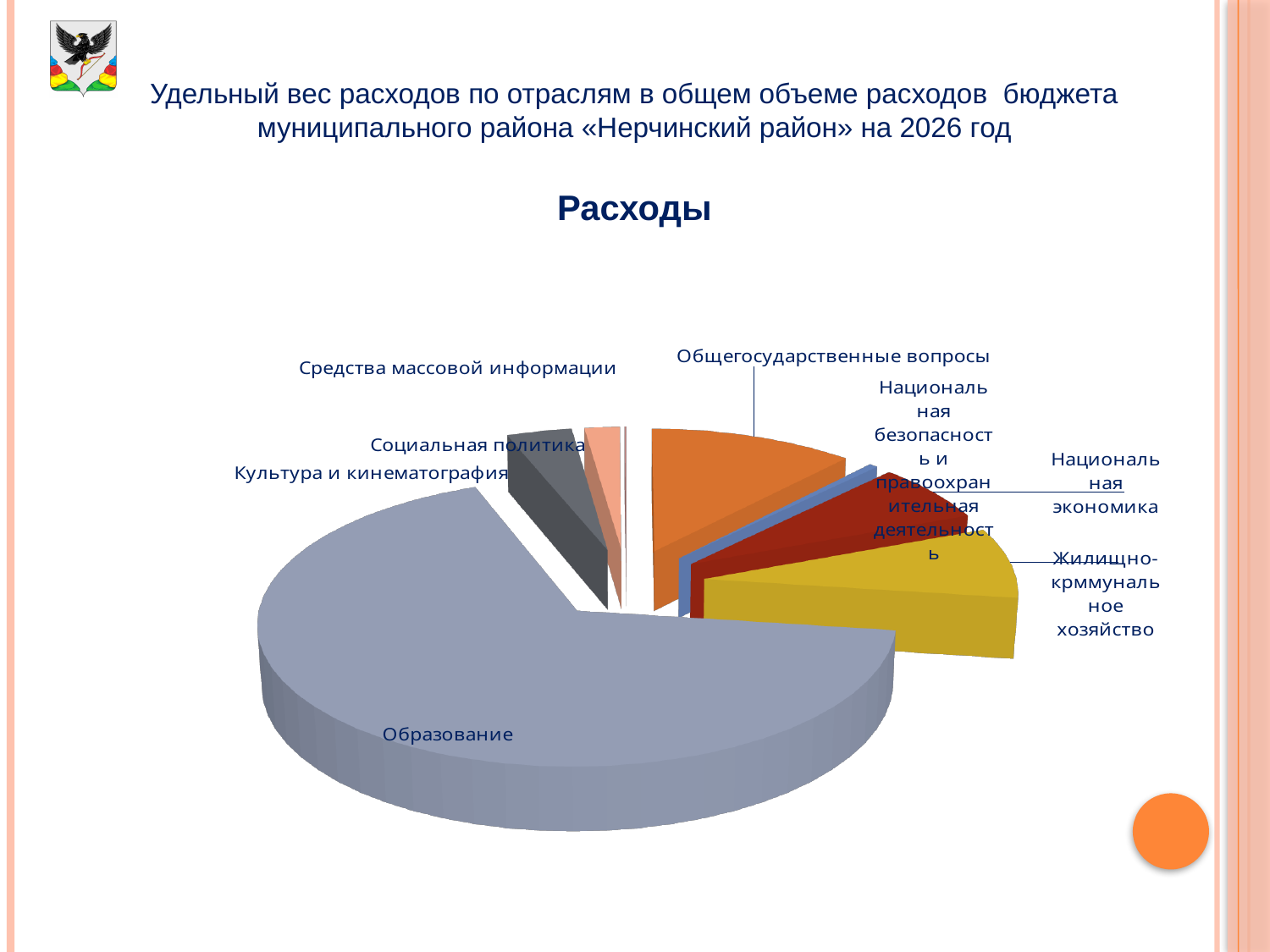
What kind of chart is shown on the slide? pie chart How many categories (slices) does the pie chart have? 8 What is the title of the chart? Расходы Which slice is larger: Жилищно-коммунальное хозяйство or Средства массовой информации? Жилищно-коммунальное хозяйство Which slice is larger: Общегосударственные вопросы or Социальная политика? Общегосударственные вопросы Which slice is larger: Образование or Общегосударственные вопросы? Образование What colour is the Образование slice? grey-blue Which category has the largest share of the pie? Образование